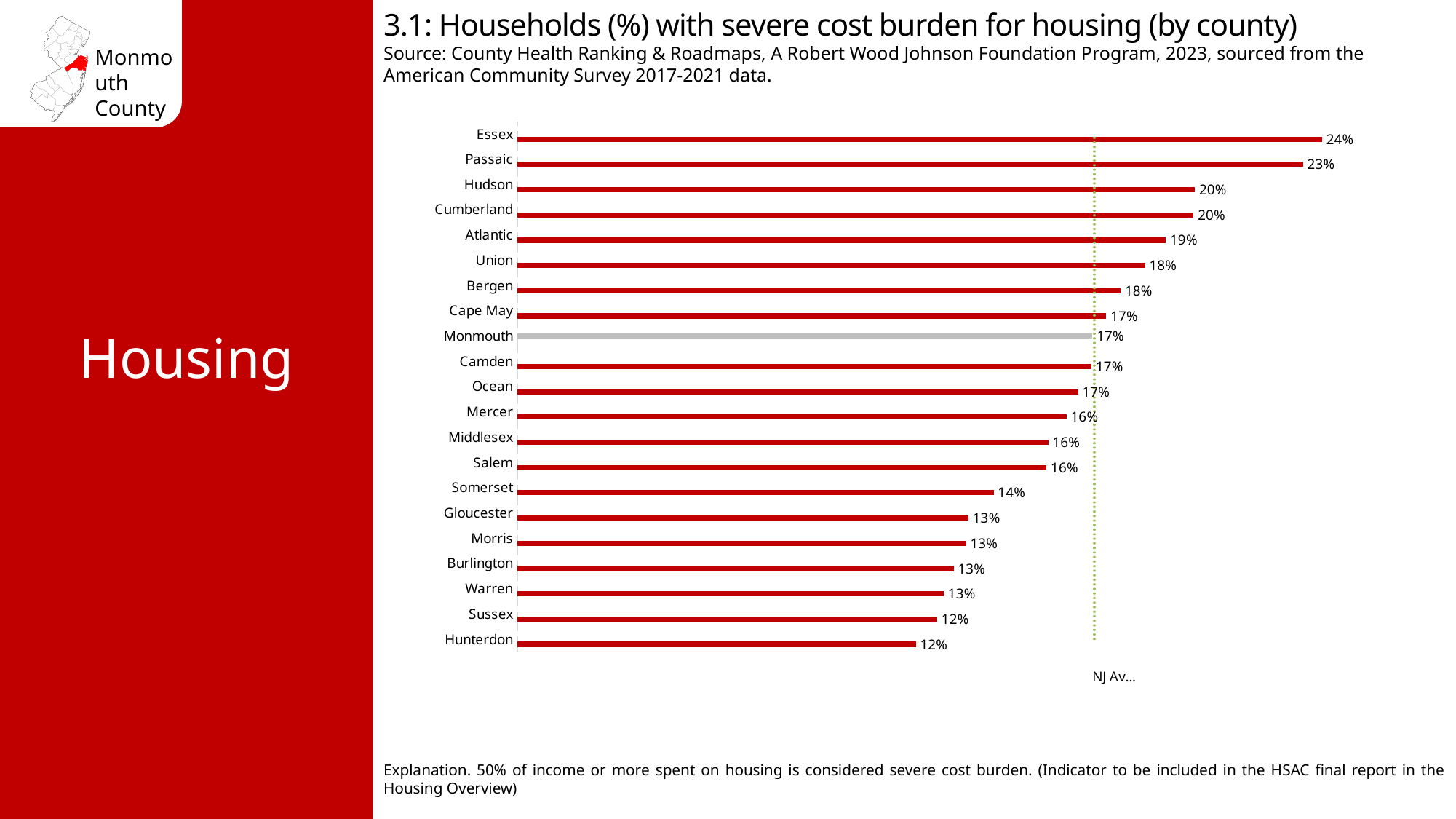
What is the difference in percentage points between Passaic and Monmouth? 6 percentage points Which has a higher value, Hudson or Somerset? Hudson What is the value shown for Somerset County? 14% Which county has the highest percentage of households with severe housing cost burden? Essex What is the value shown for Essex County? 24% What is the difference in percentage points between Essex and Hunterdon? 12 percentage points What is the value shown for Hunterdon County? 12% What percentage of households in Monmouth County have a severe cost burden for housing? 17% How many counties are shown in the chart? 21 Which county's bar is drawn in grey instead of red? Monmouth Which has a higher value, Atlantic or Gloucester? Atlantic What kind of chart is used on this slide? Bar chart